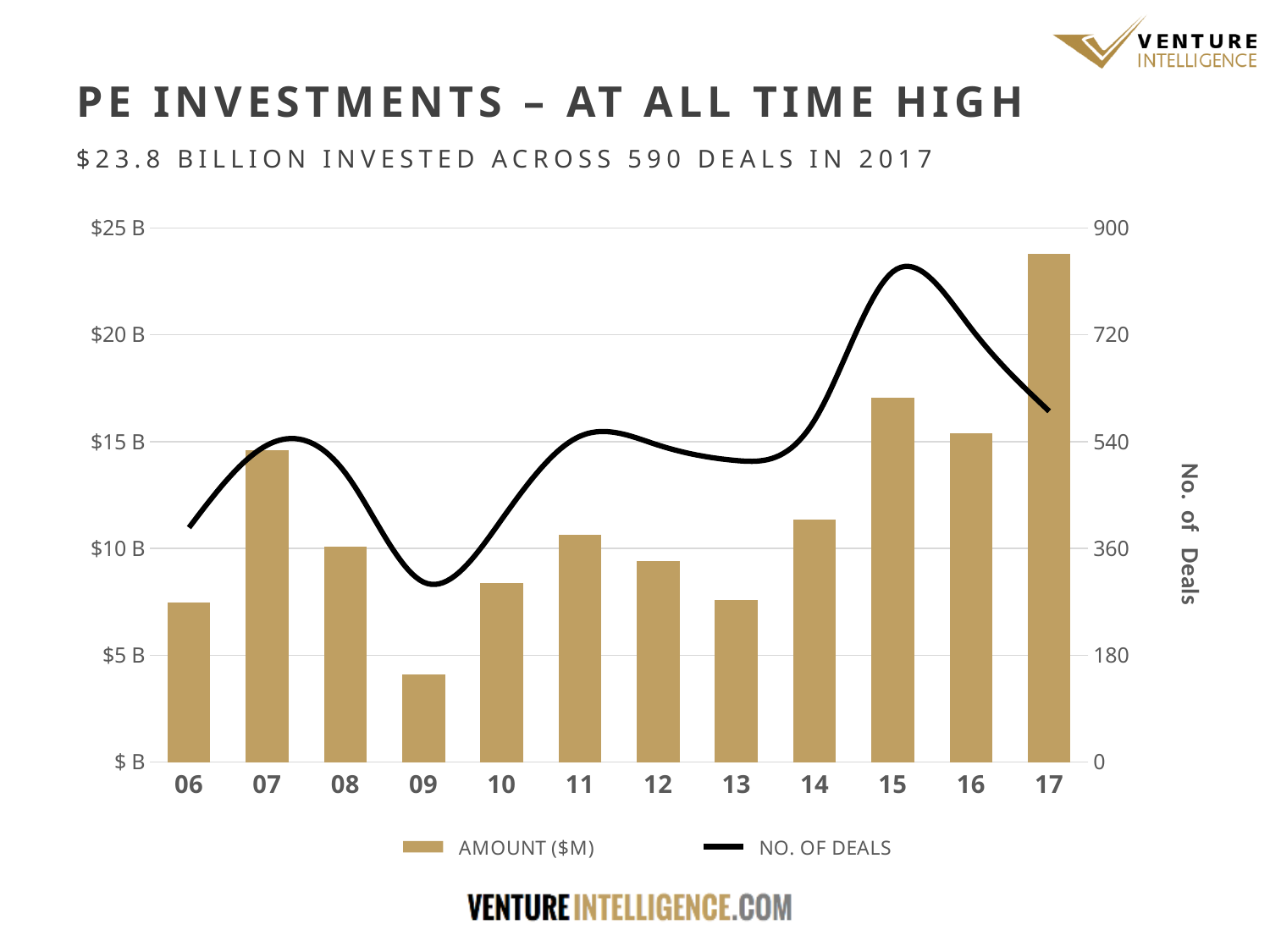
Is the AMOUNT bar for 09 greater or less than $5 B? less What kind of chart is shown on the slide? A bar chart combined with a line chart Do the AMOUNT bars rise or fall from 13 to 17? rise Is the AMOUNT bar for 15 greater or less than $15 B? greater What is the title of the right-hand vertical axis? No. of Deals Which year has the highest bar for AMOUNT ($M)? 17 Which year has the lowest bar for AMOUNT ($M)? 09 In which year does the NO. OF DEALS line reach its lowest point? 09 How many years are shown along the x axis? 12 Which year has the larger AMOUNT bar, 15 or 16? 15 In which year does the NO. OF DEALS line reach its highest point? 15 How many series does the legend list? 2